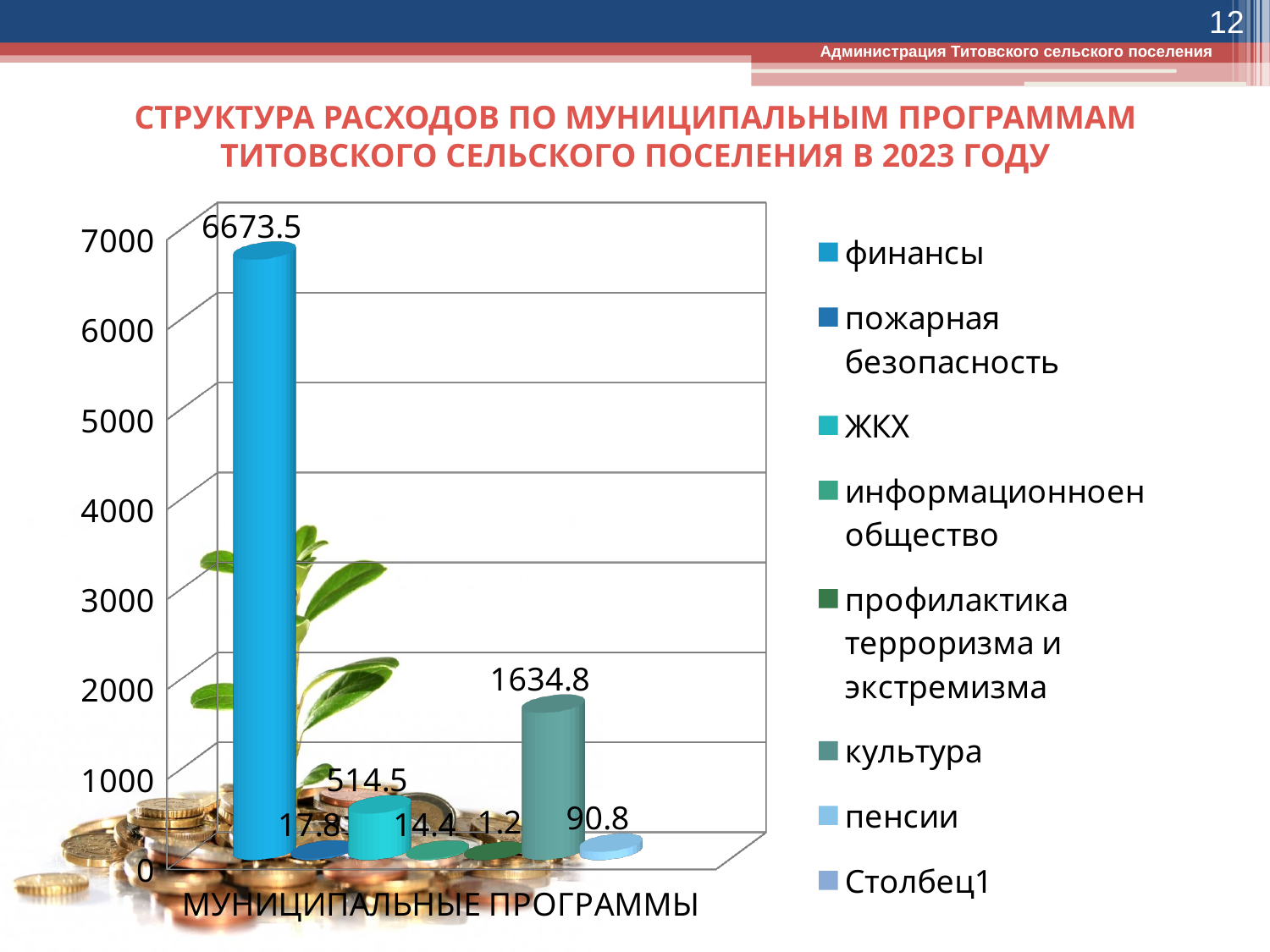
What is the value for финансы? 6673.5 What is the difference between the values for финансы and культура? 5038.7 What is the value for ЖКХ? 514.5 Which is larger, the value for ЖКХ or the value for пенсии? ЖКХ How many series does the legend list? 8 What is the value for культура? 1634.8 What is the value for пожарная безопасность? 17.8 What is the value for пенсии? 90.8 What kind of chart is shown on the slide? bar chart Which series has the lowest value? профилактика терроризма и экстремизма Which series has the highest value? финансы Is the value for культура greater or less than 2000? less